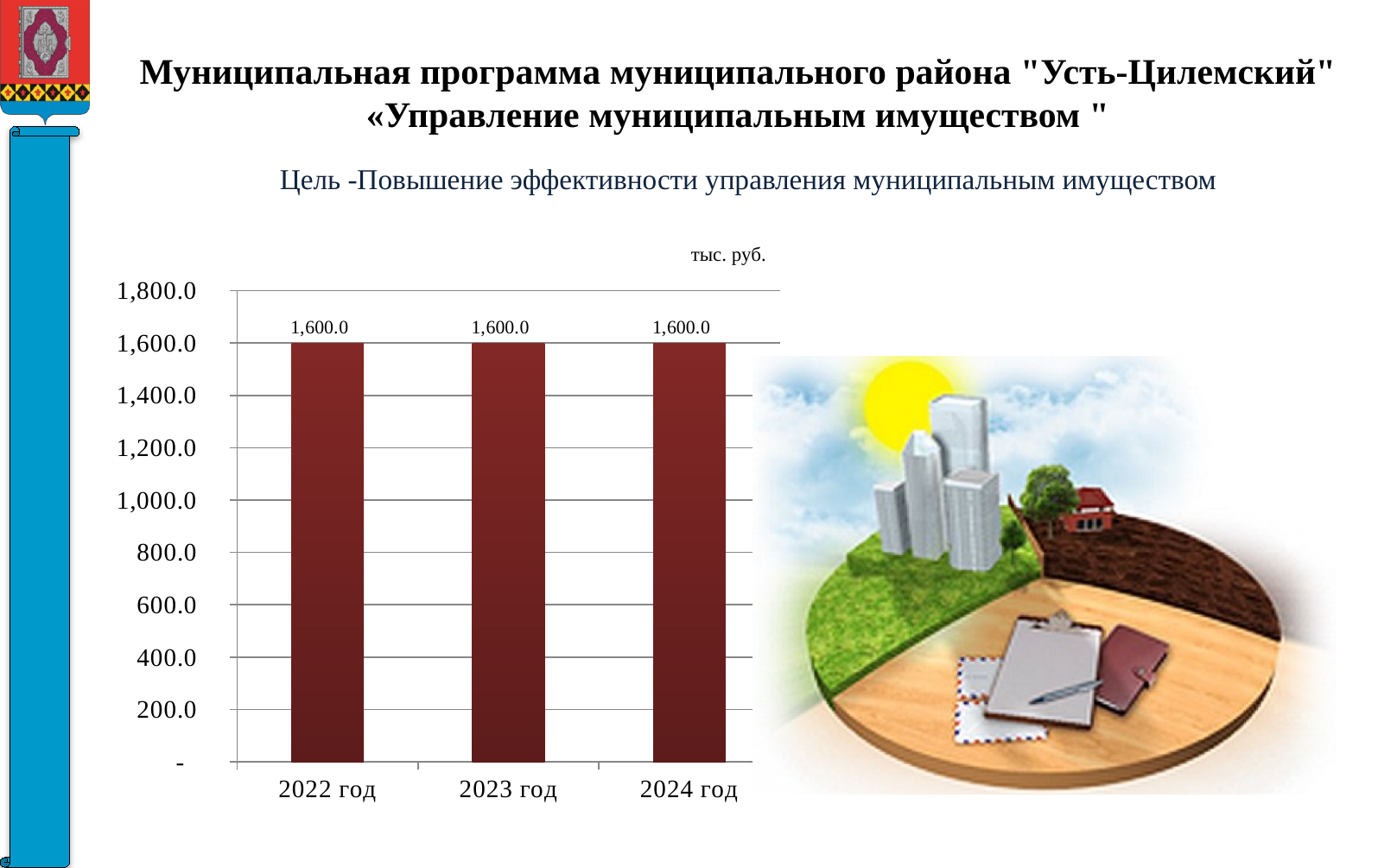
What is the value for 2023 год? 1,600.0 What unit label is shown above the chart? тыс. руб. How many categories are shown on the x axis of the chart? 3 Is the value for 2023 год greater or less than 1,400.0? greater What is the value for 2022 год? 1,600.0 Is the value for 2022 год greater or less than 1,800.0? less What is the difference between the values for 2022 год and 2024 год? 0.0 Do the values rise, fall or stay the same from 2022 год to 2024 год? stay the same What colour are the bars in the chart? dark red What kind of chart is shown on the slide? bar chart What is the value for 2024 год? 1,600.0